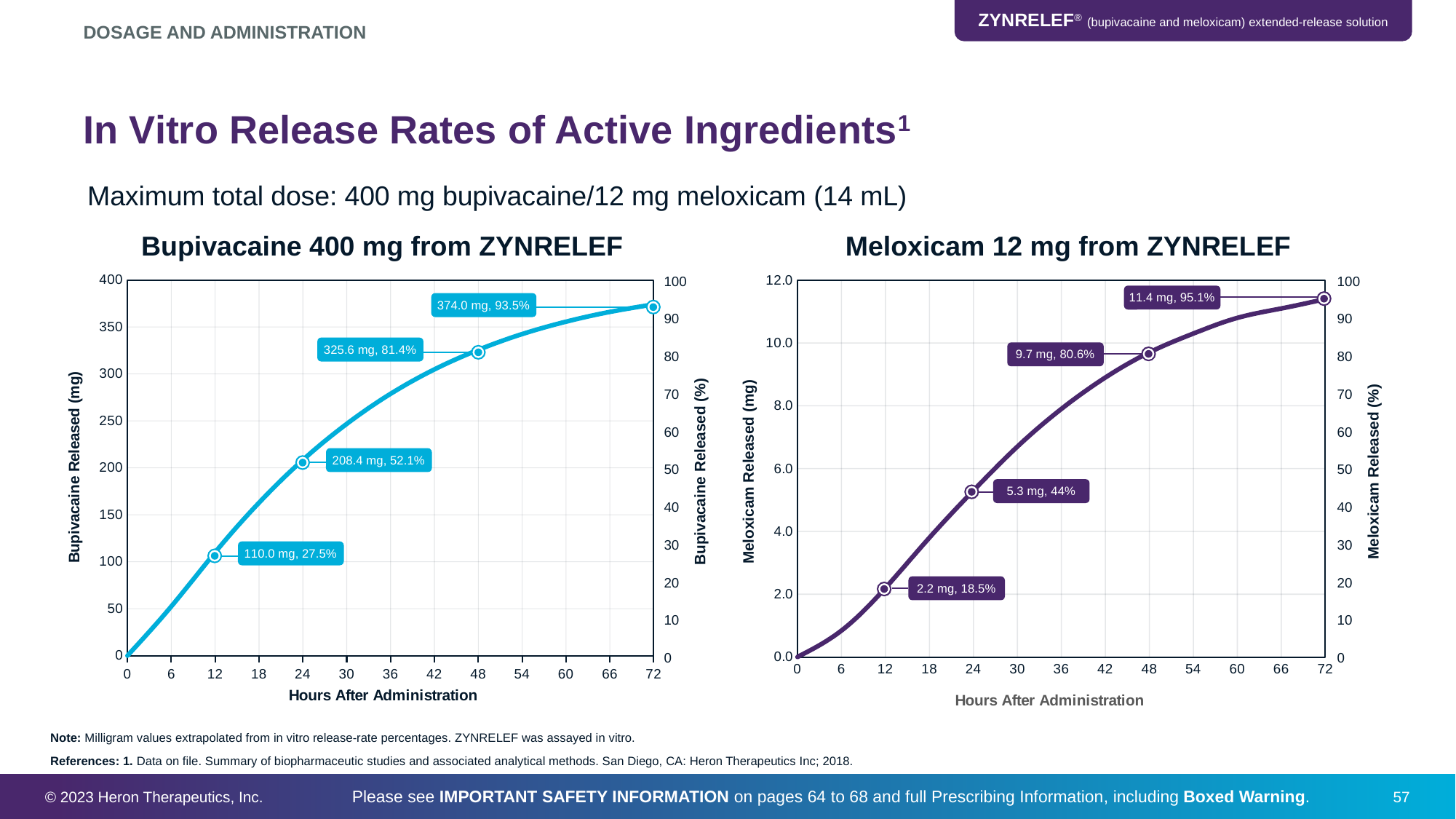
In the 'Meloxicam 12 mg from ZYNRELEF' chart, how many milligrams of meloxicam are released at 12 hours? 2.2 mg How many labeled data points are marked on the 'Meloxicam 12 mg from ZYNRELEF' chart? 4 In the 'Bupivacaine 400 mg from ZYNRELEF' chart, is the amount released at 36 hours greater or less than 250 mg? greater In the 'Meloxicam 12 mg from ZYNRELEF' chart, what percentage of meloxicam is released at 48 hours? 80.6% In the 'Bupivacaine 400 mg from ZYNRELEF' chart, how many milligrams of bupivacaine are released at 24 hours? 208.4 mg What type of chart is used for the 'Meloxicam 12 mg from ZYNRELEF' chart? Line chart In the 'Meloxicam 12 mg from ZYNRELEF' chart, what is the difference in percentage released between 72 hours and 48 hours? 14.5% In the 'Bupivacaine 400 mg from ZYNRELEF' chart, does the amount released rise or fall as hours after administration increase? Rise Which is larger: the percentage of bupivacaine released at 12 hours or the percentage of meloxicam released at 12 hours? Bupivacaine at 12 hours (27.5%) In the 'Bupivacaine 400 mg from ZYNRELEF' chart, what is the difference in milligrams released between 48 hours and 24 hours? 117.2 mg In the 'Bupivacaine 400 mg from ZYNRELEF' chart, what percentage of bupivacaine is released at 72 hours? 93.5%